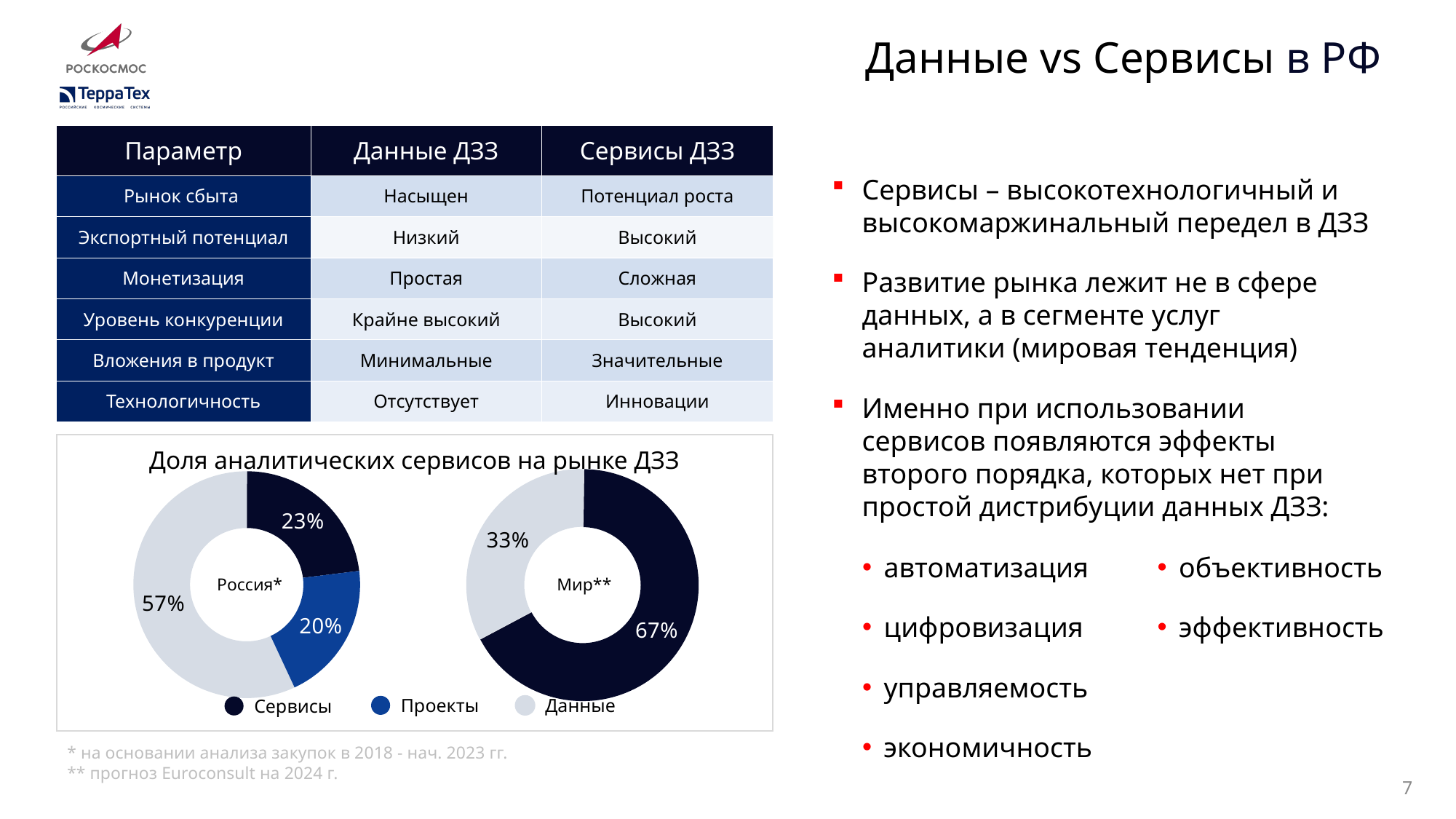
In the "Россия*" donut chart, what share do Проекты have? 20% What is the difference between the share of Сервисы in the "Мир**" chart and in the "Россия*" chart? 44% In the "Россия*" donut chart, what share do Данные have? 57% Which is larger: the share of Данные in the "Россия*" chart or in the "Мир**" chart? Россия* How many entries does the shared legend of the donut charts list? 3 In the "Россия*" donut chart, what share do Сервисы have? 23% In the "Россия*" donut chart, which category has the largest share? Данные What is the title of the chart area containing the two donut charts? Доля аналитических сервисов на рынке ДЗЗ In the "Мир**" donut chart, what share do Сервисы have? 67% In the "Мир**" donut chart, what share do Данные have? 33% In the "Россия*" donut chart, which category has the smallest share? Проекты In the "Мир**" donut chart, which category has the largest share? Сервисы